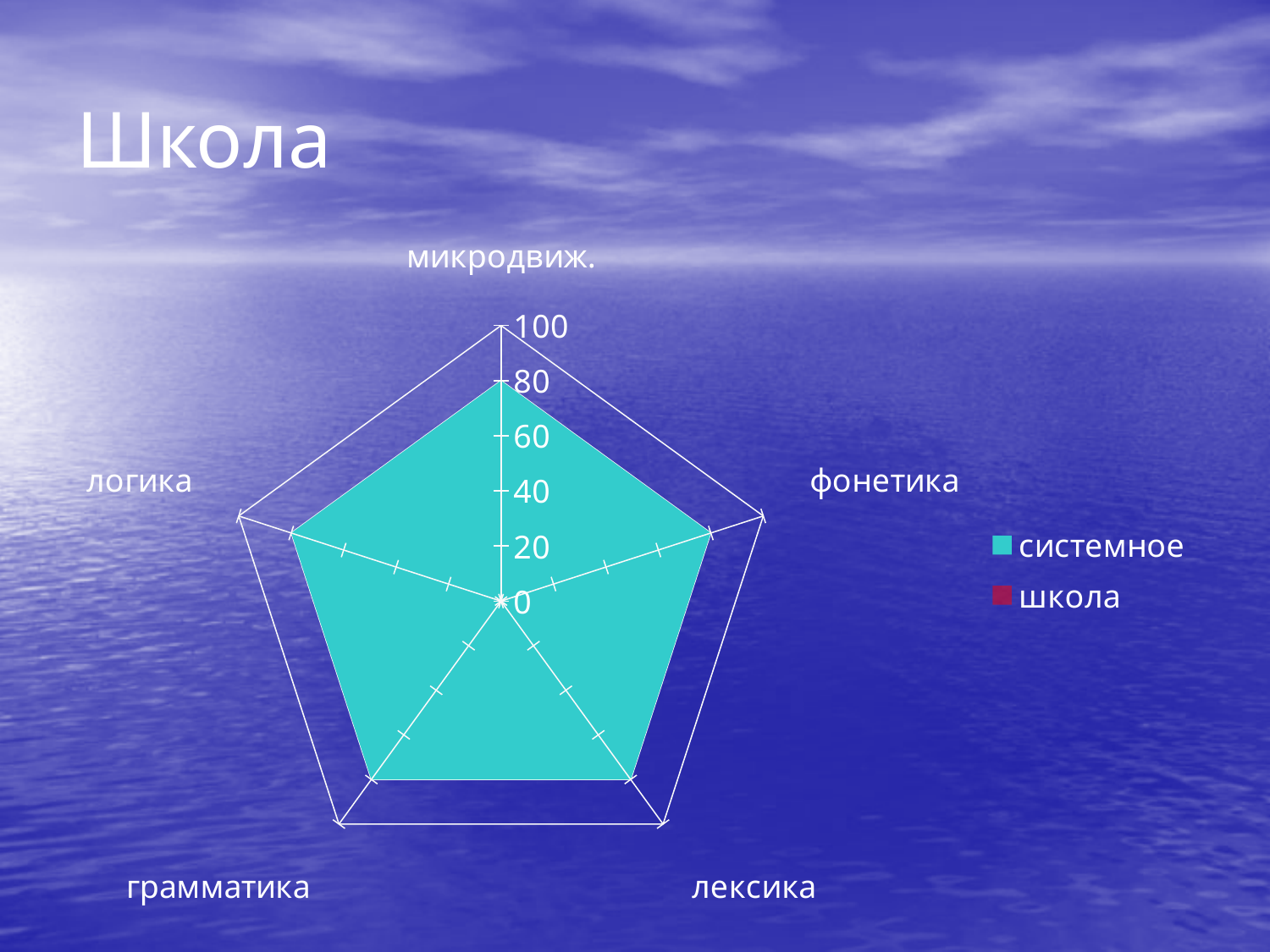
Is the value for грамматика in the системное series greater or less than 40? greater What are the two series names listed in the legend? системное, школа Is the value for логика in the системное series greater or less than 100? less How many series does the legend list? 2 What is the value for микродвиж. in the системное series? 80 Is the value for лексика in the системное series greater or less than 100? less What kind of chart is shown on the slide? radar chart What is the maximum value shown on the chart's axis scale? 100 How many categories (axes) does the radar chart have? 5